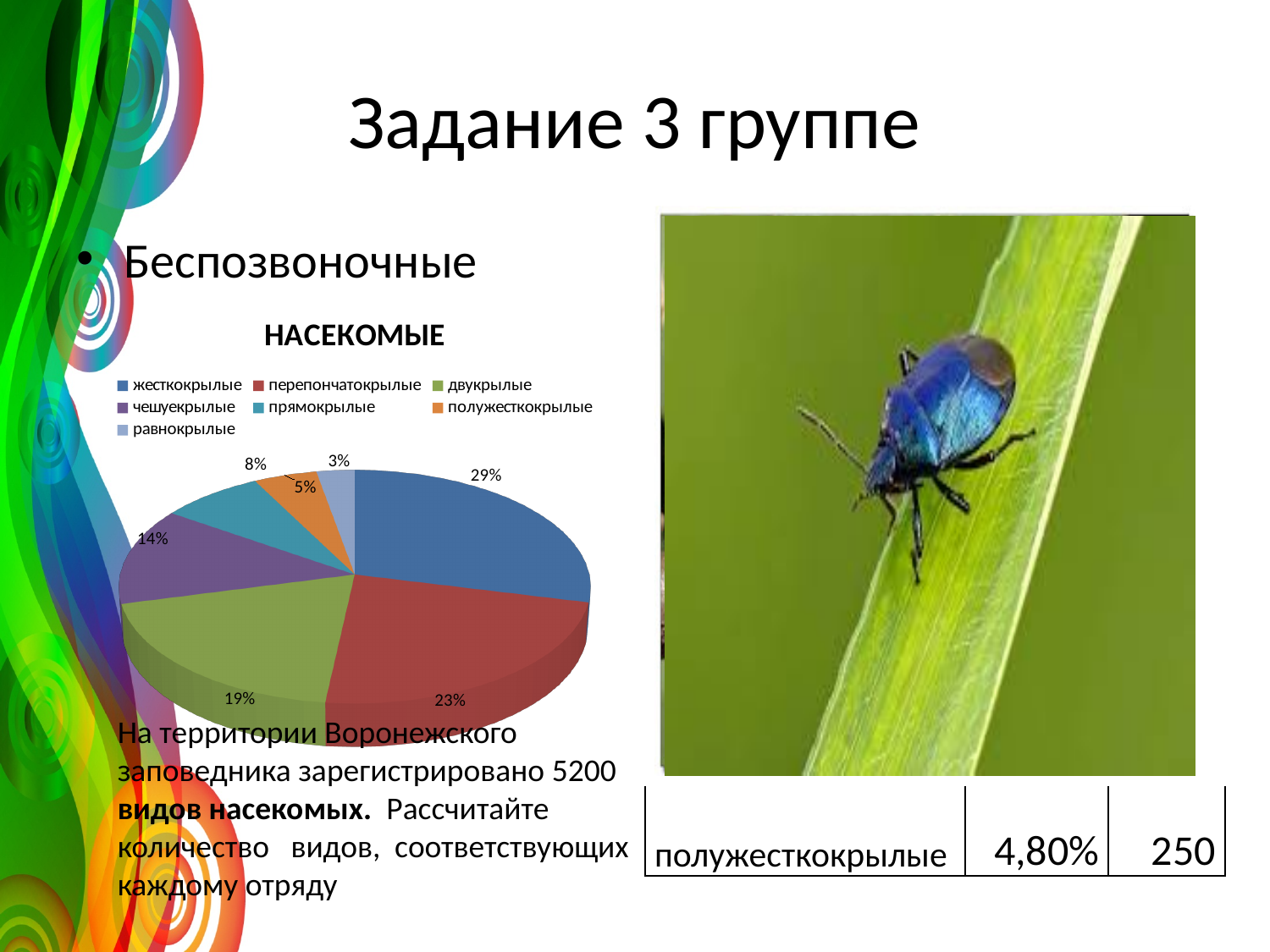
What is the title of the pie chart? НАСЕКОМЫЕ What percentage is shown for полужесткокрылые in the pie chart? 5% What is the difference in percentage points between жесткокрылые and перепончатокрылые in the pie chart? 6 Which category has the smallest slice in the pie chart? равнокрылые Which category has the largest slice in the pie chart? жесткокрылые What percentage is shown for перепончатокрылые in the pie chart? 23% How many categories does the legend of the pie chart list? 7 What type of chart is shown under the heading НАСЕКОМЫЕ? pie chart What percentage is shown for чешуекрылые in the pie chart? 14% What percentage is shown for двукрылые in the pie chart? 19% Which slice is larger in the pie chart, прямокрылые or чешуекрылые? чешуекрылые What share of the pie chart does жесткокрылые have? 29%